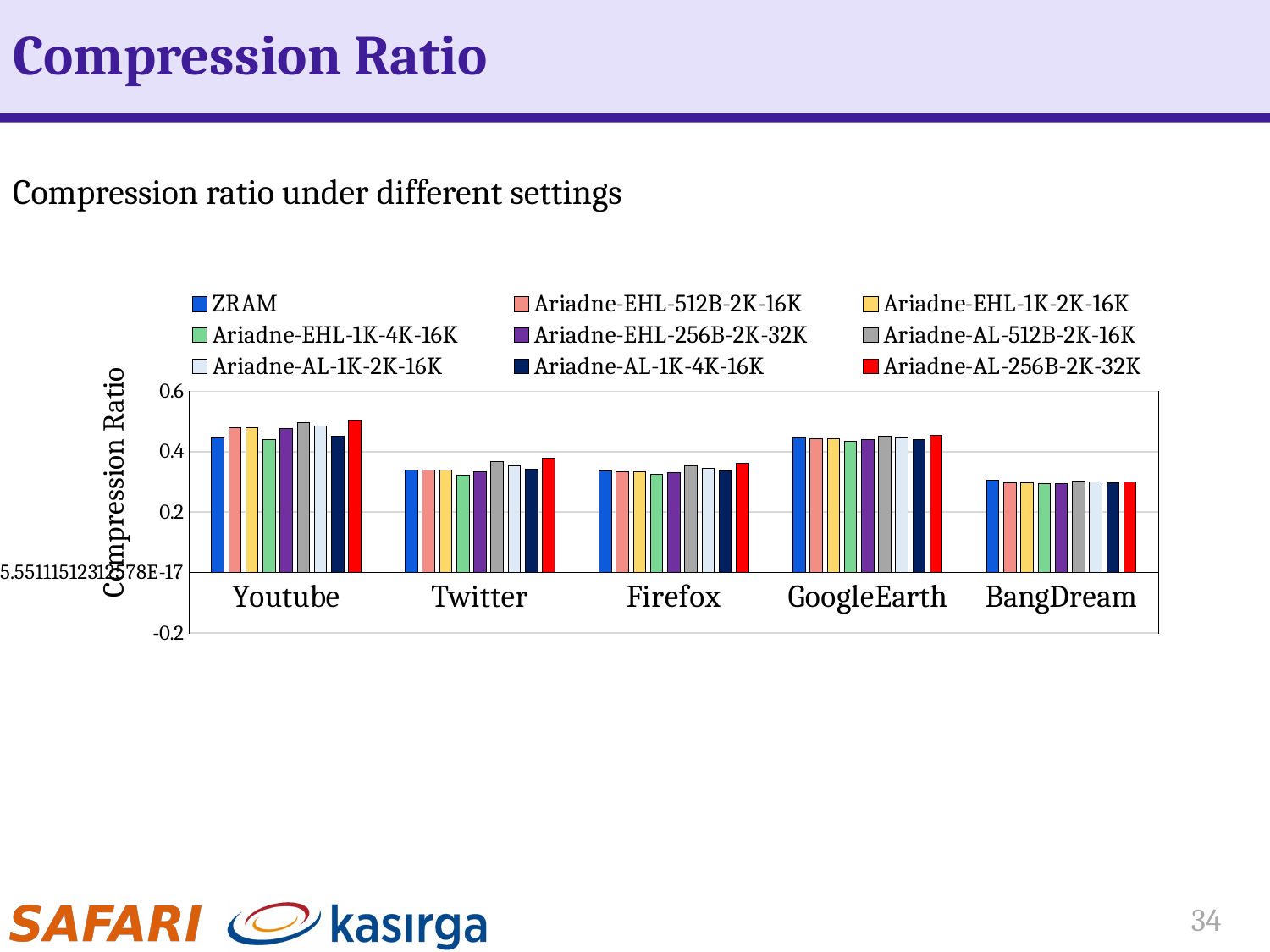
How many series does the chart's legend list? 9 Is the ZRAM compression ratio for Youtube greater or less than 0.4? greater Is the ZRAM compression ratio for BangDream greater or less than 0.4? less Is the ZRAM compression ratio for Twitter greater or less than 0.4? less Which has the larger ZRAM compression ratio, GoogleEarth or Twitter? GoogleEarth Which application has the lowest compression ratios overall in the chart? BangDream How many categories (applications) are shown on the x axis of the chart? 5 What is the label of the chart's y axis? Compression Ratio Which has the larger ZRAM compression ratio, Youtube or BangDream? Youtube What kind of chart is shown on the slide? bar chart